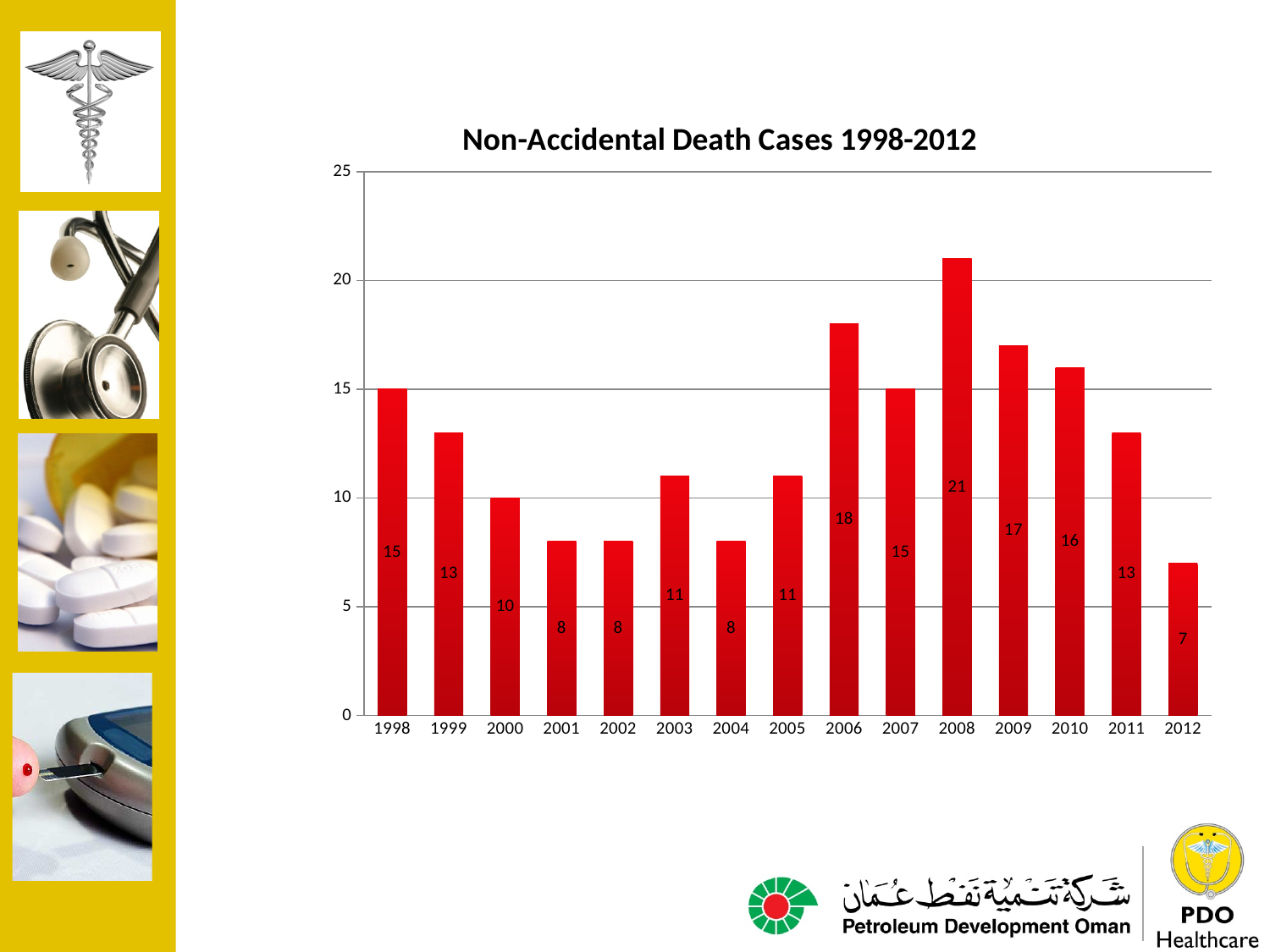
Which year has the highest number of non-accidental death cases? 2008 What is the difference between the values for 2008 and 2012? 14 What is the value for 2008? 21 How many years are shown on the x axis? 15 Is the value for 2006 greater or less than 15? greater What kind of chart is this? bar chart What is the title of the chart? Non-Accidental Death Cases 1998-2012 Which year has the lowest number of non-accidental death cases? 2012 Do the values rise or fall from 2008 to 2012? fall What is the value for 2012? 7 Which is larger, the value for 2009 or the value for 2010? 2009 What is the value for 2006? 18